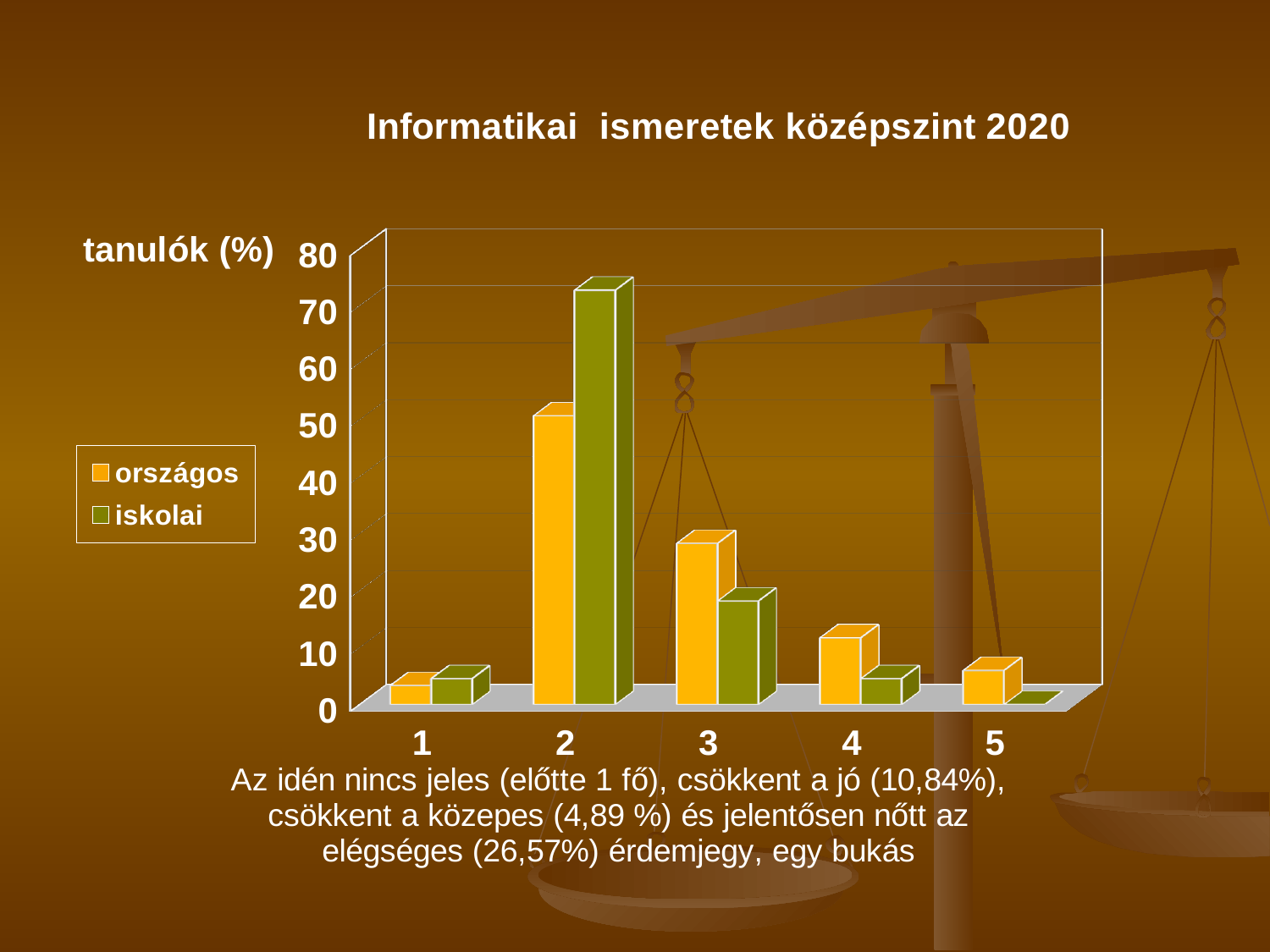
Which category has the highest value for the országos series? 2 How many series does the legend list? 2 What kind of chart is shown on the slide? bar chart For category 2, which series has the larger value, országos or iskolai? iskolai Which category has the highest value for the iskolai series? 2 How many categories are shown on the x axis? 5 Which category has the lowest value for the iskolai series? 5 What is the title of the chart? Informatikai ismeretek középszint 2020 Is the országos value for category 3 greater or less than 20? greater Is the iskolai value for category 2 greater or less than 70? greater Is the országos value for category 2 greater or less than 60? less For category 3, which series has the larger value, országos or iskolai? országos